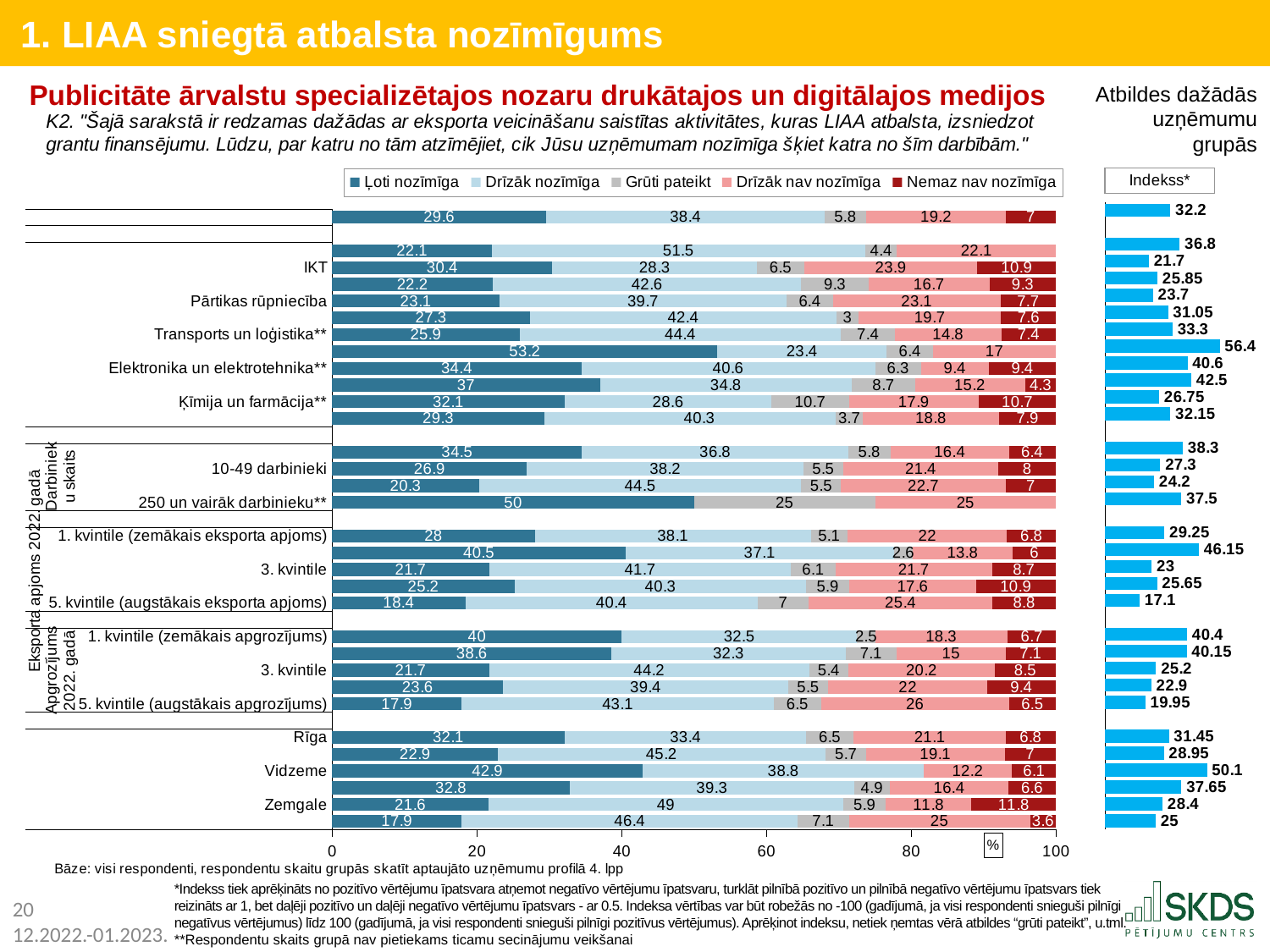
How many series does the legend of the main chart list? 5 In the Indekss* chart, what is the index value for Vidzeme? 50.1 In the main chart, what is the 'Drīzāk nav nozīmīga' value for Elektronika un elektrotehnika**? 9.4 In the main chart, what is the 'Drīzāk nozīmīga' value for Zemgale? 49 In the Indekss* chart, what is the index value for 250 un vairāk darbinieku**? 37.5 In the main chart, which is larger: the 'Ļoti nozīmīga' value for Vidzeme or for Rīga? Vidzeme In the main chart, what is the difference between the 'Ļoti nozīmīga' values for 1. kvintile (zemākais apgrozījums) and 5. kvintile (augstākais apgrozījums)? 22.1 In the Indekss* chart, which of Rīga, Vidzeme and Zemgale has the highest index value? Vidzeme In the main chart, what is the 'Grūti pateikt' value for Ķīmija un farmācija**? 10.7 What type of chart is the main chart on the slide? Stacked bar chart In the main chart, what is the 'Ļoti nozīmīga' value for IKT? 30.4 In the Indekss* chart, what is the index value for 5. kvintile (augstākais eksporta apjoms)? 17.1